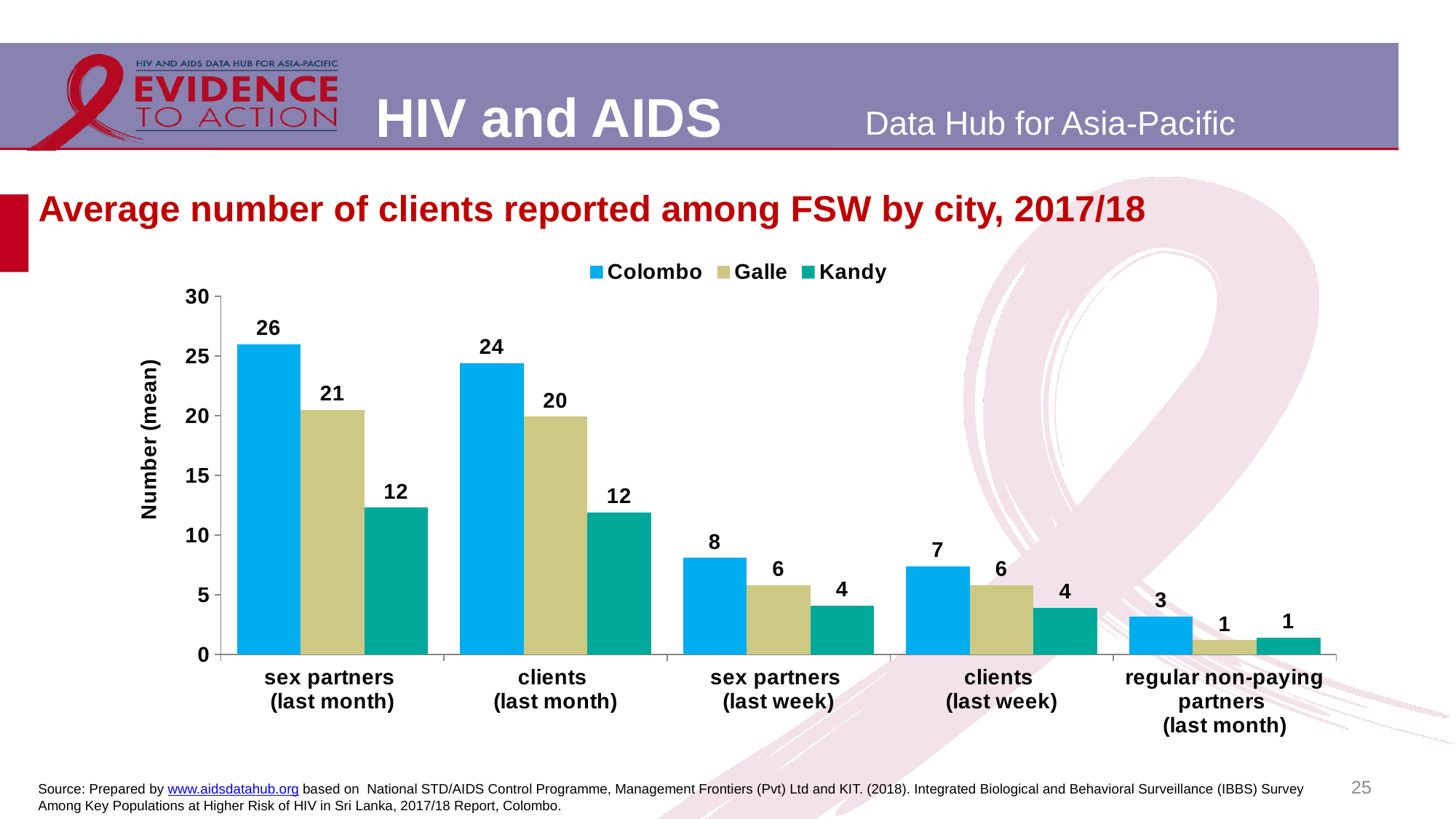
How many series does the legend list? 3 What is the difference between Colombo and Galle for clients (last month)? 4 Which city has the lowest value for sex partners (last month)? Kandy Is the value for Galle for sex partners (last month) greater or less than 20? greater Which is larger: Colombo for sex partners (last week) or Kandy for sex partners (last month)? Kandy for sex partners (last month) What is the label of the y axis? Number (mean) Which city has the highest value for clients (last week)? Colombo What kind of chart is shown on the slide? bar chart How many categories are shown on the x axis? 5 What is the value for Colombo for sex partners (last month)? 26 What is the value for Kandy for clients (last month)? 12 What is the value for Galle for sex partners (last week)? 6